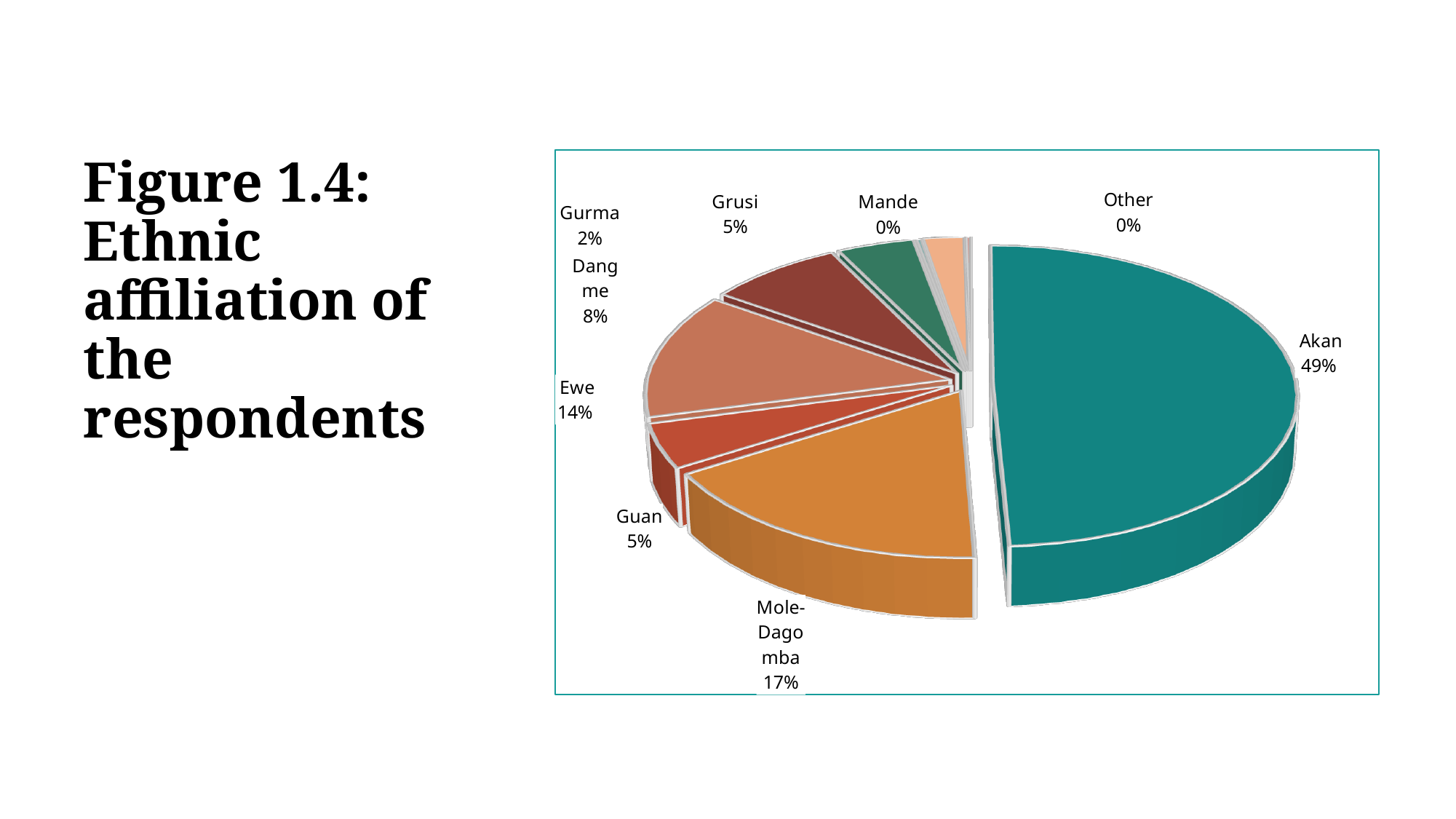
What share of respondents are Ewe? 14% What kind of chart is shown on the slide? Pie chart What share of respondents are Dangme? 8% Which is larger, the Ewe share or the Dangme share? Ewe What percentage is shown for Mande? 0% What share of respondents are Gurma? 2% What share of respondents are Mole-Dagomba? 17% Which ethnic group has the largest share of respondents? Akan How many ethnic categories are labelled on the pie chart? 9 What is the difference in percentage points between the Akan and Mole-Dagomba shares? 32 What share of respondents are Akan? 49% What is the title of the figure on the slide? Figure 1.4: Ethnic affiliation of the respondents